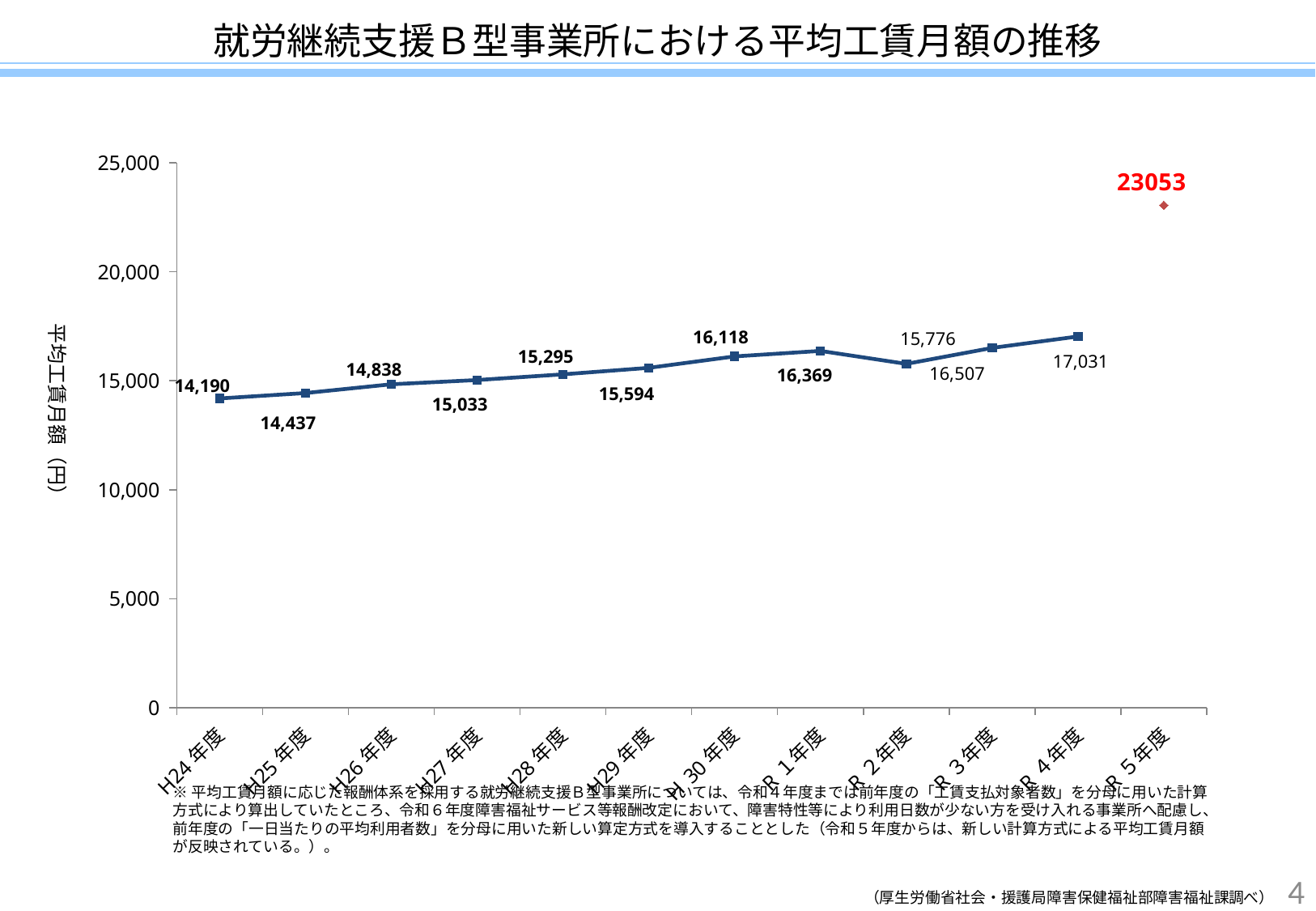
What is the difference between the values for R4年度 and R3年度? 524 How many fiscal years are shown on the x axis? 12 What kind of chart is shown on the slide? line chart What is the average monthly wage for H24年度? 14,190 What is the average monthly wage for H30年度? 16,118 What is the average monthly wage for R2年度? 15,776 Is the value for H27年度 greater or less than 15,000? greater Which fiscal year has the lowest average monthly wage? H24年度 What is the value shown for R5年度? 23053 What is the label of the vertical axis? 平均工賃月額（円） Which fiscal year has the highest value on the chart? R5年度 Which is larger, the value for R1年度 or the value for R2年度? R1年度